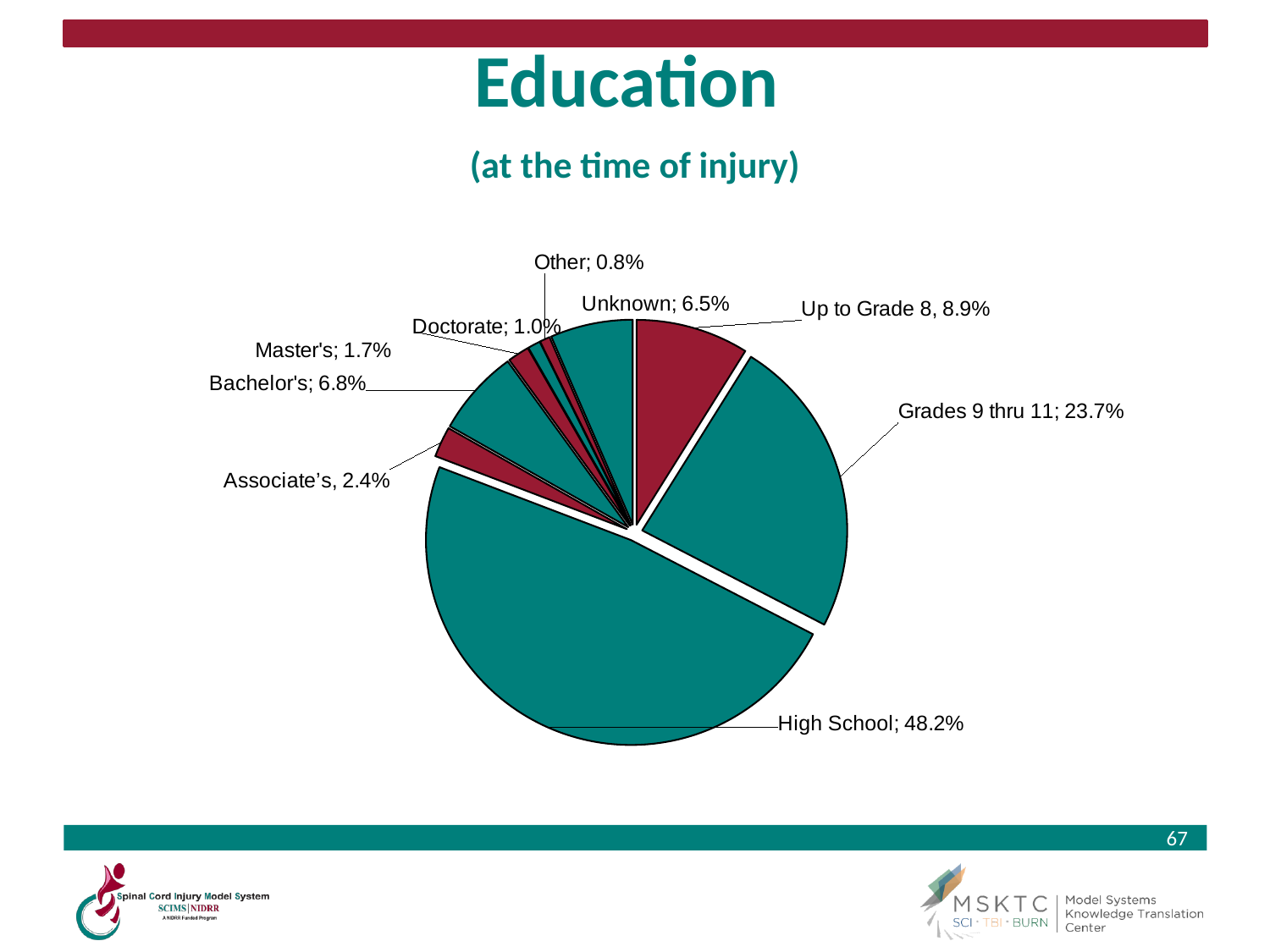
Which is larger, the share for Unknown or the share for Up to Grade 8? Up to Grade 8 What kind of chart is shown on the slide? Pie chart What share of the pie is Grades 9 thru 11? 23.7% What is the difference in percentage points between High School and Grades 9 thru 11? 24.5 What share of the pie is Bachelor's? 6.8% What is the title of the chart on the slide? Education (at the time of injury) How many categories are shown in the pie chart? 9 What share of the pie is Doctorate? 1.0% Which category has the smallest slice of the pie? Other What is the difference in percentage points between Bachelor's and Master's? 5.1 What share of the pie is High School? 48.2% Which category has the largest slice of the pie? High School